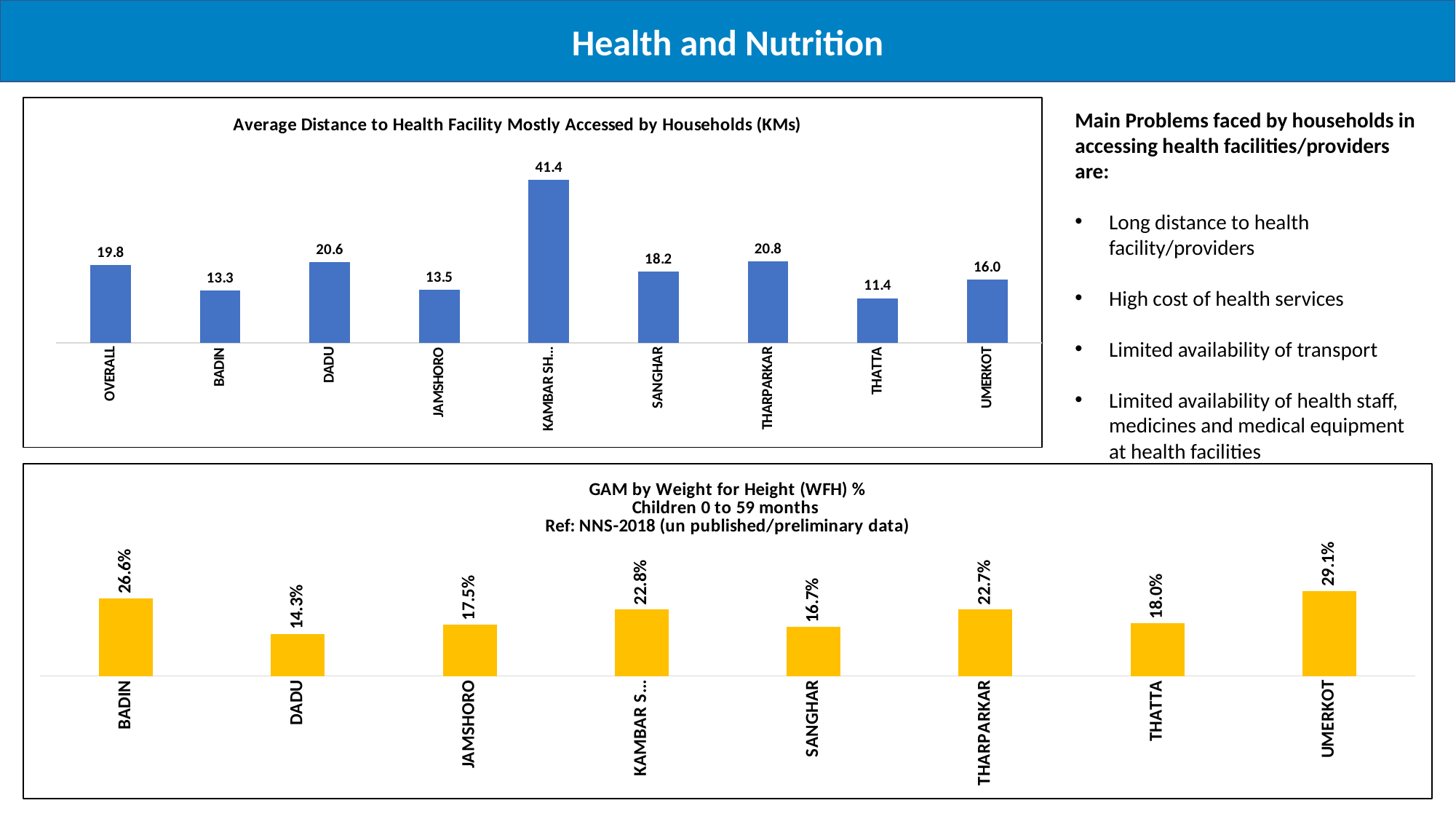
In the top chart, what is the value for Thatta? 11.4 In the top chart, what is the difference between the values for Tharparkar and Badin? 7.5 In the bottom chart, which district has the highest GAM percentage? UMERKOT In the top chart, which district has the lowest average distance to a health facility? THATTA What is the title of the top chart? Average Distance to Health Facility Mostly Accessed by Households (KMs) What type of chart is the bottom chart? Bar chart In the bottom chart, which district has the lowest GAM percentage? DADU In the top chart, which is larger, the value for Sanghar or the value for Umerkot? Sanghar How many bars are shown in the top chart? 9 In the bottom chart, what is the GAM by weight for height for Badin? 26.6% In the top chart, what is the average distance to a health facility for Dadu? 20.6 In the bottom chart, what is the difference between the values for Umerkot and Dadu? 14.8%